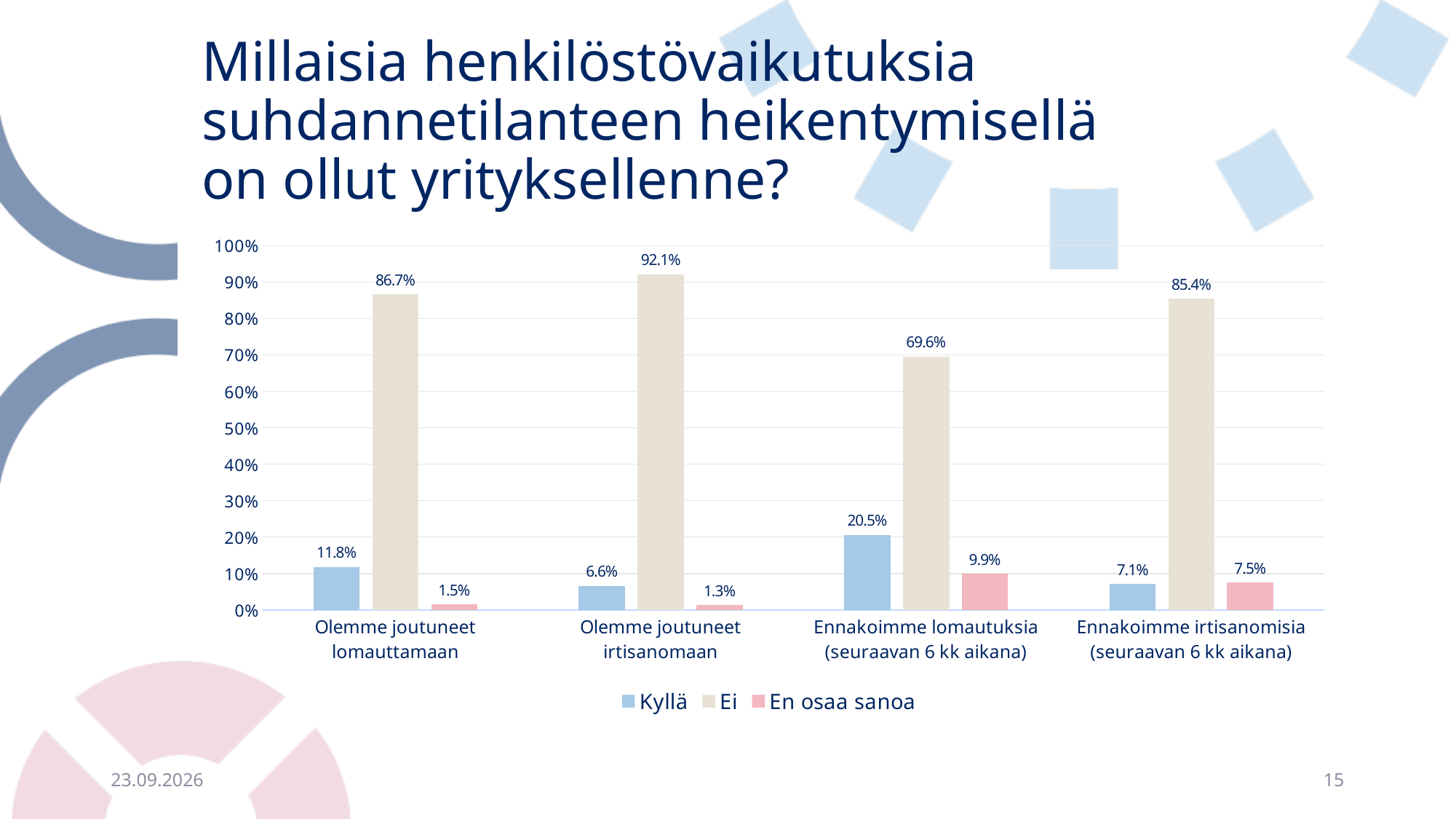
Which category has the highest Kyllä value? Ennakoimme lomautuksia (seuraavan 6 kk aikana) What is the Kyllä value for "Ennakoimme irtisanomisia (seuraavan 6 kk aikana)"? 7.1% What is the Kyllä value for "Olemme joutuneet lomauttamaan"? 11.8% What kind of chart is shown on the slide? Bar chart Which is larger: the Kyllä value for "Olemme joutuneet lomauttamaan" or the Kyllä value for "Olemme joutuneet irtisanomaan"? Olemme joutuneet lomauttamaan What is the difference between the Ei values for "Olemme joutuneet irtisanomaan" and "Olemme joutuneet lomauttamaan"? 5.4% What is the En osaa sanoa value for "Ennakoimme lomautuksia (seuraavan 6 kk aikana)"? 9.9% What is the Ei value for "Olemme joutuneet irtisanomaan"? 92.1% How many series does the legend list? 3 Which series is shown in pink in the legend? En osaa sanoa How many categories are shown on the x axis? 4 Which category has the lowest Ei value? Ennakoimme lomautuksia (seuraavan 6 kk aikana)